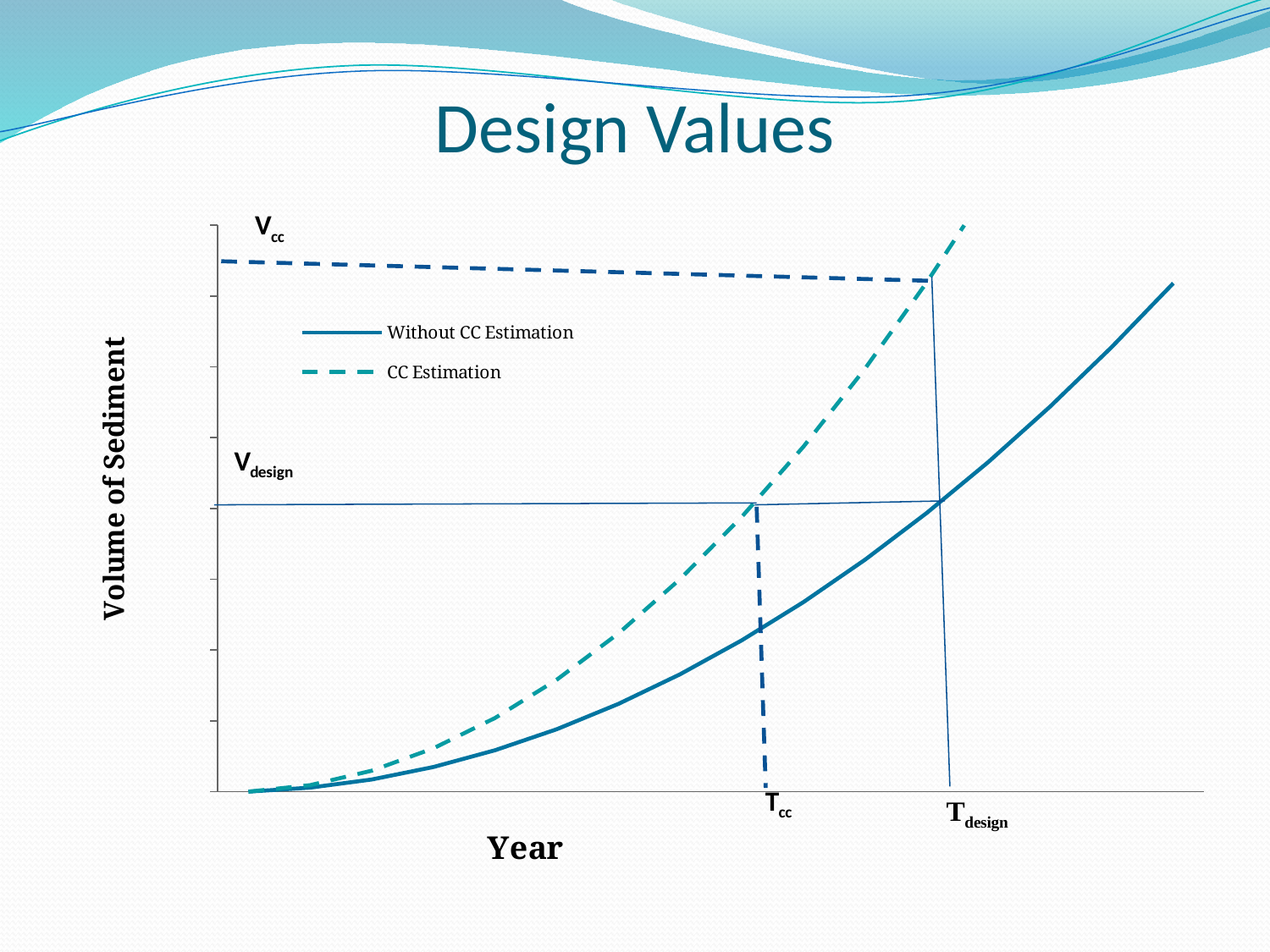
What is the title of the chart? Design Values Which series is drawn with a dashed line? CC Estimation What kind of chart is shown on the slide? Line chart What is the label of the y axis? Volume of Sediment At year T_design, which series has the higher volume of sediment, CC Estimation or Without CC Estimation? CC Estimation At year T_cc, which series has the higher volume of sediment, CC Estimation or Without CC Estimation? CC Estimation Do the values of the CC Estimation series rise or fall along the x axis? Rise Do the values of the Without CC Estimation series rise or fall along the x axis? Rise Which is larger, V_cc or V_design? V_cc How many series does the legend list? 2